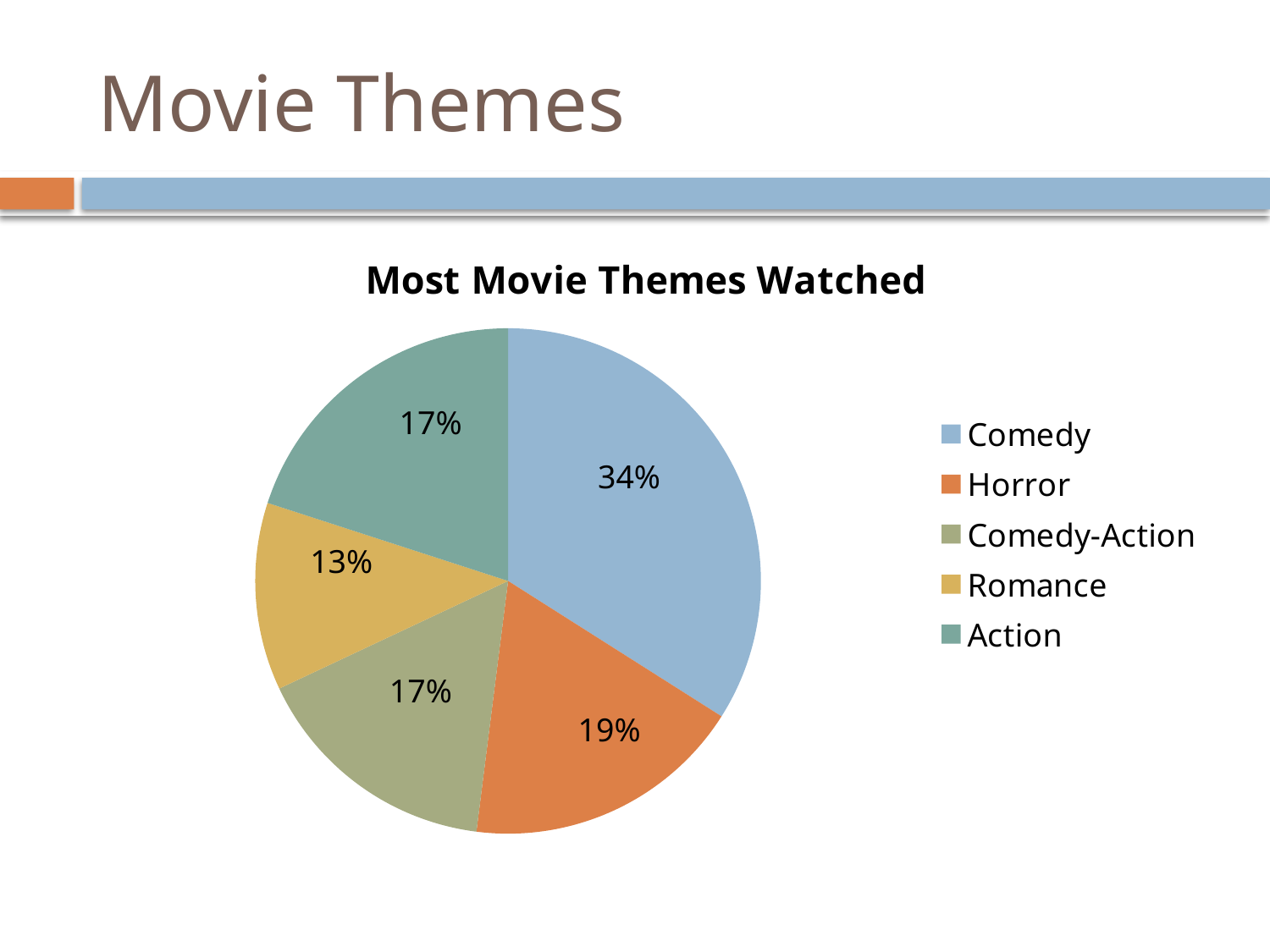
What share of the pie does Horror have? 19% What is the title of the chart? Most Movie Themes Watched What share of the pie does Romance have? 13% What type of chart is shown on the slide? pie chart What is the difference in percentage points between Comedy and Horror? 15 Which has a larger share, Horror or Romance? Horror Which movie theme has the largest share of the pie? Comedy What share of the pie does Comedy have? 34% How many categories does the pie chart show? 5 Which movie theme has the smallest share of the pie? Romance What is the combined share of Comedy-Action and Action? 34%